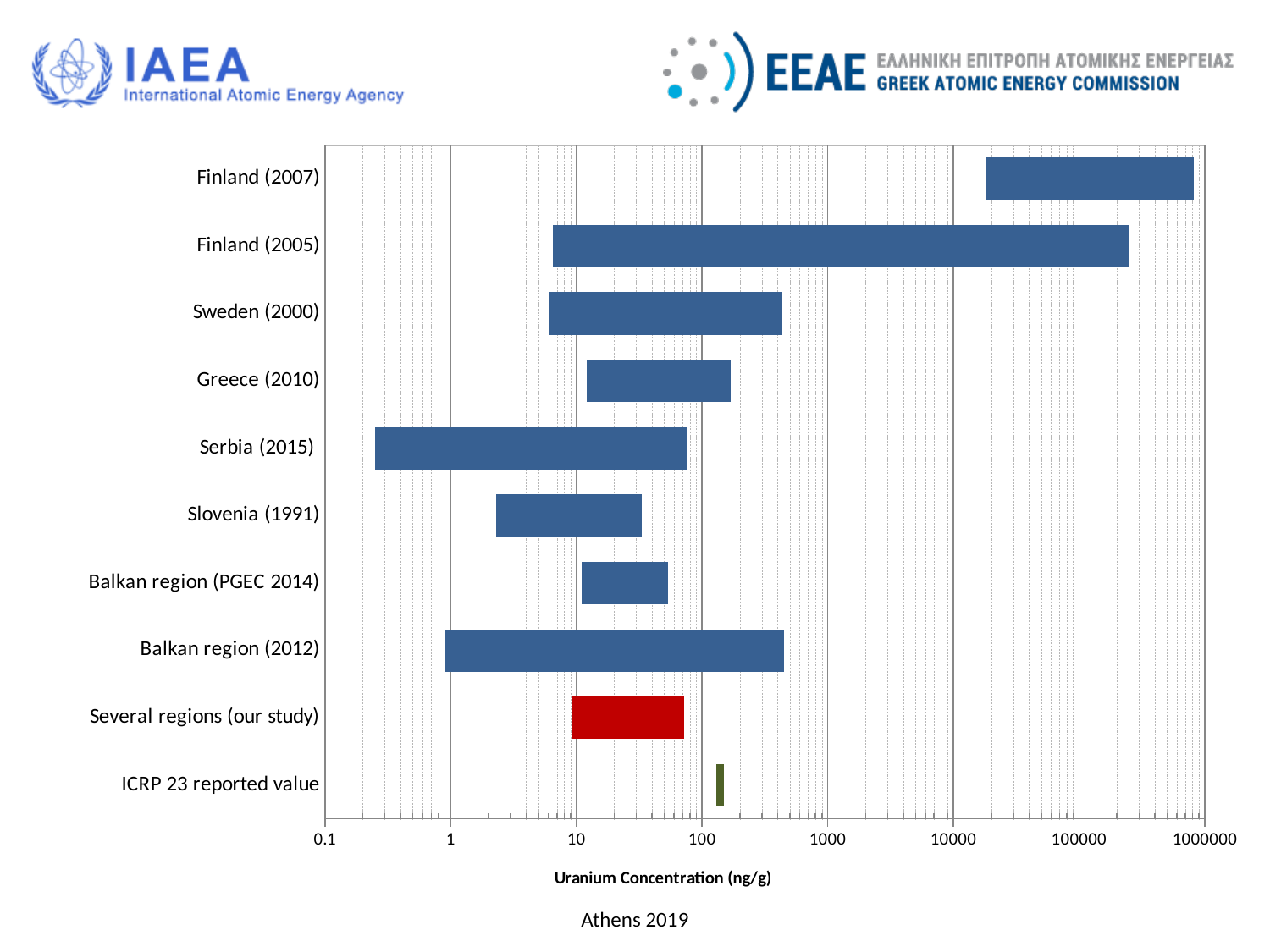
Is the upper end of the Several regions (our study) bar greater or less than 100 ng/g? less Which category has the narrowest bar on the chart? ICRP 23 reported value Which category's bar reaches the highest uranium concentration on the chart? Finland (2007) What kind of chart is shown on the slide? bar chart What is the title of the horizontal axis of the chart? Uranium Concentration (ng/g) How many categories are listed on the vertical axis of the chart? 10 Is the upper end of the Greece (2010) bar greater or less than 1000 ng/g? less Which bar spans a wider range of uranium concentration: Finland (2005) or Greece (2010)? Finland (2005) What colour is the bar for Several regions (our study)? red Is the ICRP 23 reported value greater or less than 100 ng/g? greater Which category's bar extends to the lowest uranium concentration on the chart? Serbia (2015)